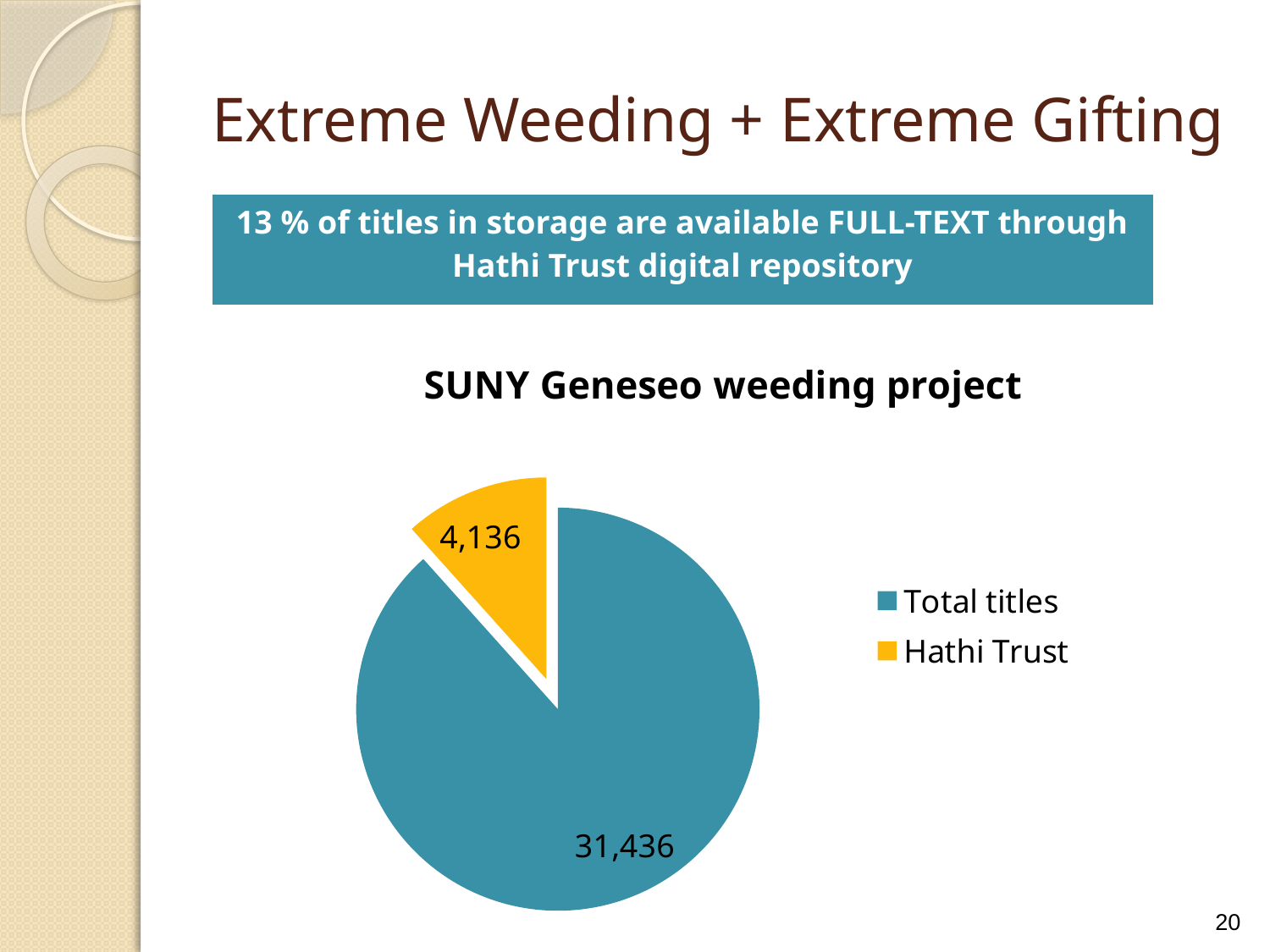
What is the difference between the Total titles value and the Hathi Trust value? 27,300 What is the sum of the two values shown on the pie chart? 35,572 What is the title of the chart? SUNY Geneseo weeding project Which slice of the pie is the largest? Total titles What is the value shown for Hathi Trust? 4,136 What is the value shown for Total titles? 31,436 What type of chart is shown on the slide? Pie chart Which is larger, the Total titles slice or the Hathi Trust slice? Total titles How many slices does the pie chart have? 2 Which slice of the pie is the smallest? Hathi Trust How many entries does the legend list? 2 What colour is the Hathi Trust slice? Yellow